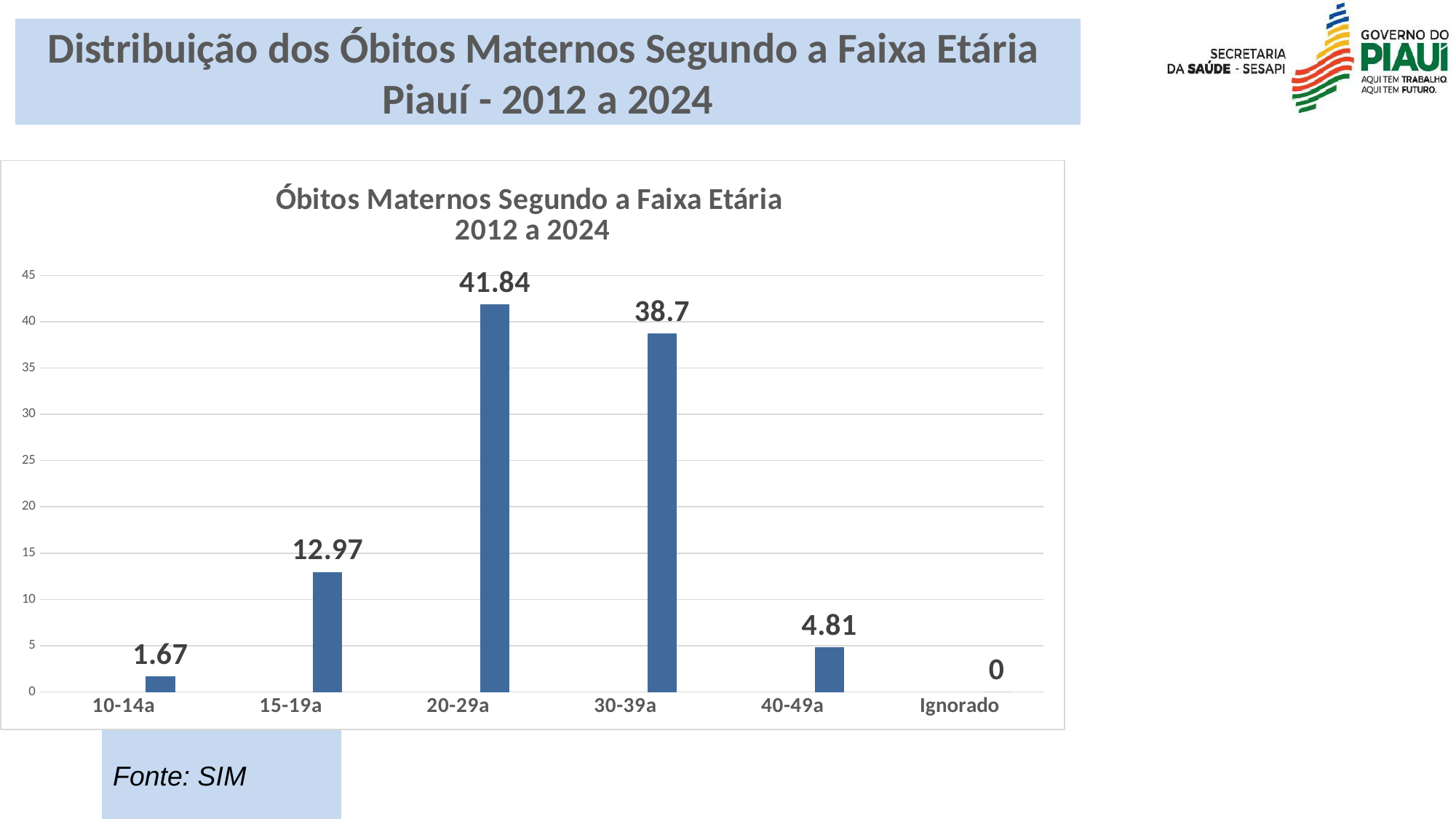
What is the value for the 20-29a age group? 41.84 What kind of chart is shown on the slide? bar chart Which age group has the highest value? 20-29a What is the value for the 10-14a age group? 1.67 What is the value for the Ignorado category? 0 How many age-group categories are shown on the x axis? 6 Is the value for 30-39a greater or less than 35? greater What is the difference between the values for 20-29a and 30-39a? 3.14 What is the title of the chart? Óbitos Maternos Segundo a Faixa Etária 2012 a 2024 Which is larger, the value for 15-19a or the value for 40-49a? 15-19a Which category has the lowest value? Ignorado What is the value for the 40-49a age group? 4.81